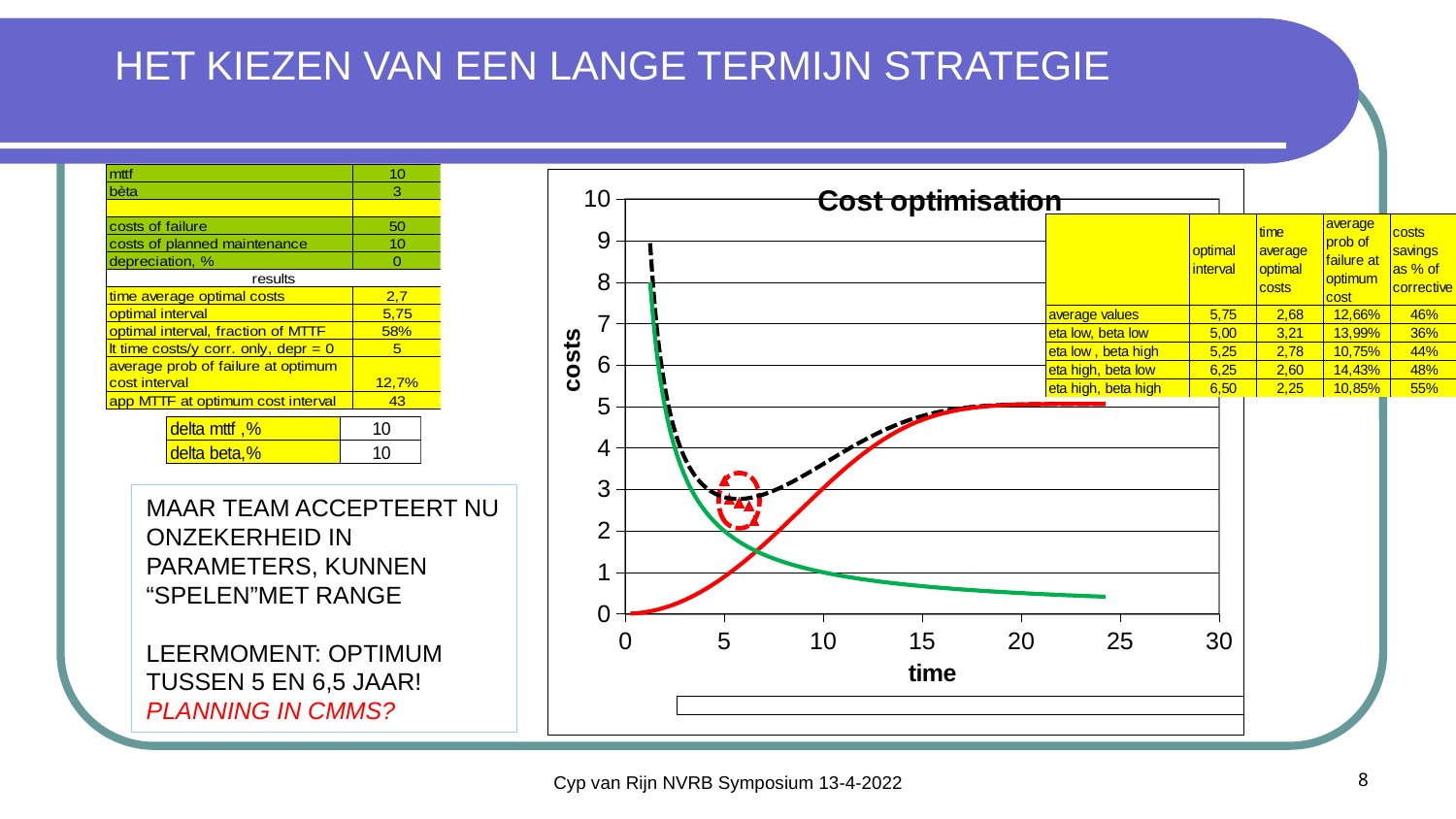
On the 'Cost optimisation' chart, does the red line rise or fall as time increases? rise What is the label of the x axis of the 'Cost optimisation' chart? time On the 'Cost optimisation' chart, is the value of the black dashed line at time 5 greater or less than 4? less On the 'Cost optimisation' chart, is the value of the green line at time 20 greater or less than 1? less What kind of chart is the 'Cost optimisation' chart? line chart What is the title of the chart on the slide? Cost optimisation On the 'Cost optimisation' chart, at time 2, which line has the larger value, the green line or the red line? green line On the 'Cost optimisation' chart, does the green line rise or fall as time increases? fall On the 'Cost optimisation' chart, is the value of the red line at time 20 greater or less than 4? greater How many lines are plotted on the 'Cost optimisation' chart? 3 On the 'Cost optimisation' chart, at time 20, which line has the larger value, the red line or the green line? red line